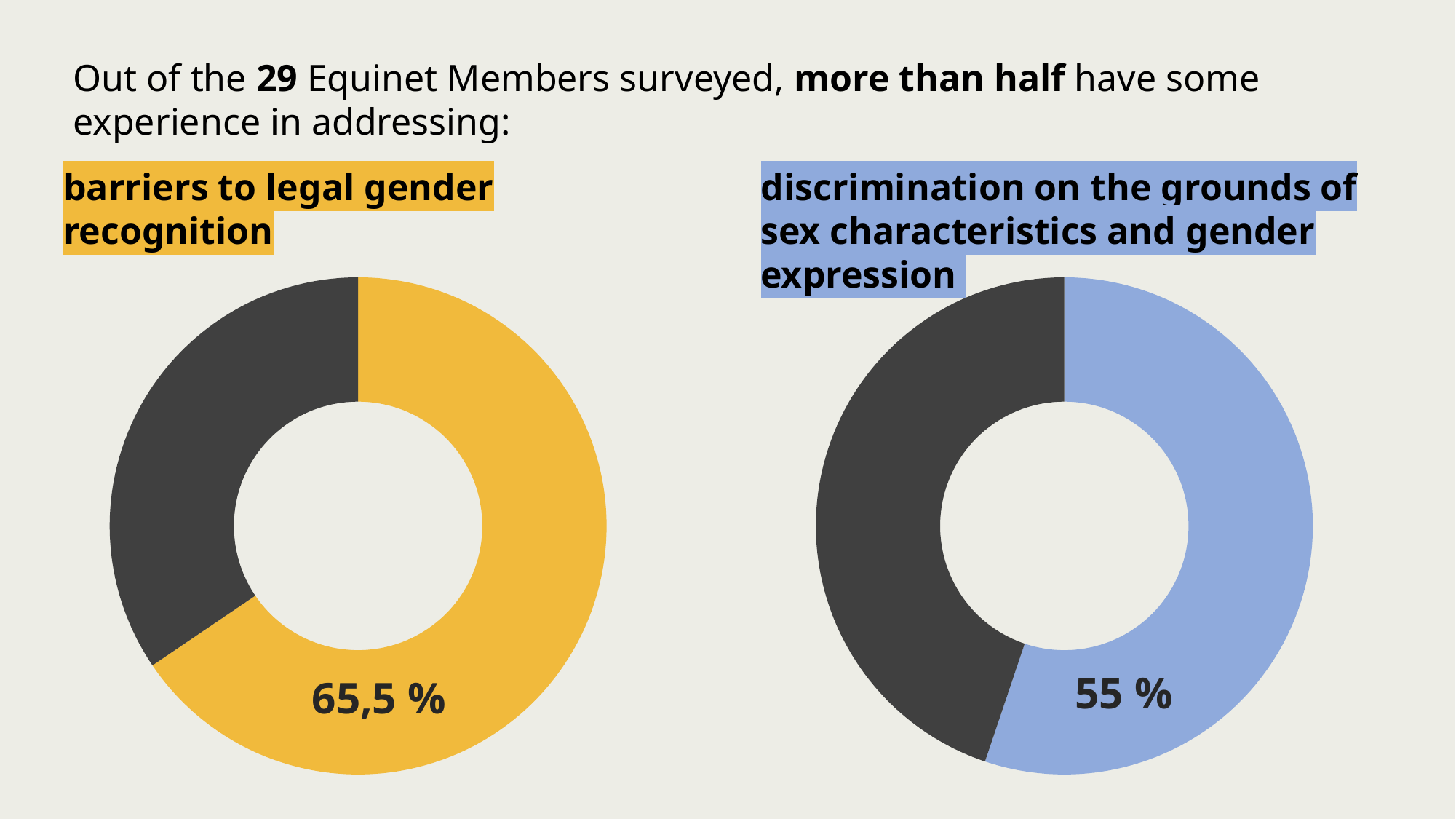
Which labelled share is larger: the 'barriers to legal gender recognition' slice on the left chart or the 'discrimination on the grounds of sex characteristics and gender expression' slice on the right chart? barriers to legal gender recognition On the left chart, which slice is larger: the yellow slice or the dark grey slice? The yellow slice How many Equinet Members were surveyed, according to the slide text? 29 How many slices does the left chart have? 2 On the left chart (barriers to legal gender recognition), what percentage is shown on the yellow slice? 65,5 % On the right chart, which slice is larger: the blue slice or the dark grey slice? The blue slice What is the difference in percentage points between the labelled slice on the left chart (65,5 %) and the labelled slice on the right chart (55 %)? 10,5 percentage points What kind of chart is used on the left of the slide? Donut (pie) chart What colour is the labelled slice on the left chart? Yellow What kind of chart is used on the right of the slide? Donut (pie) chart How many slices does the right chart have? 2 On the right chart (discrimination on the grounds of sex characteristics and gender expression), what percentage is shown on the blue slice? 55 %